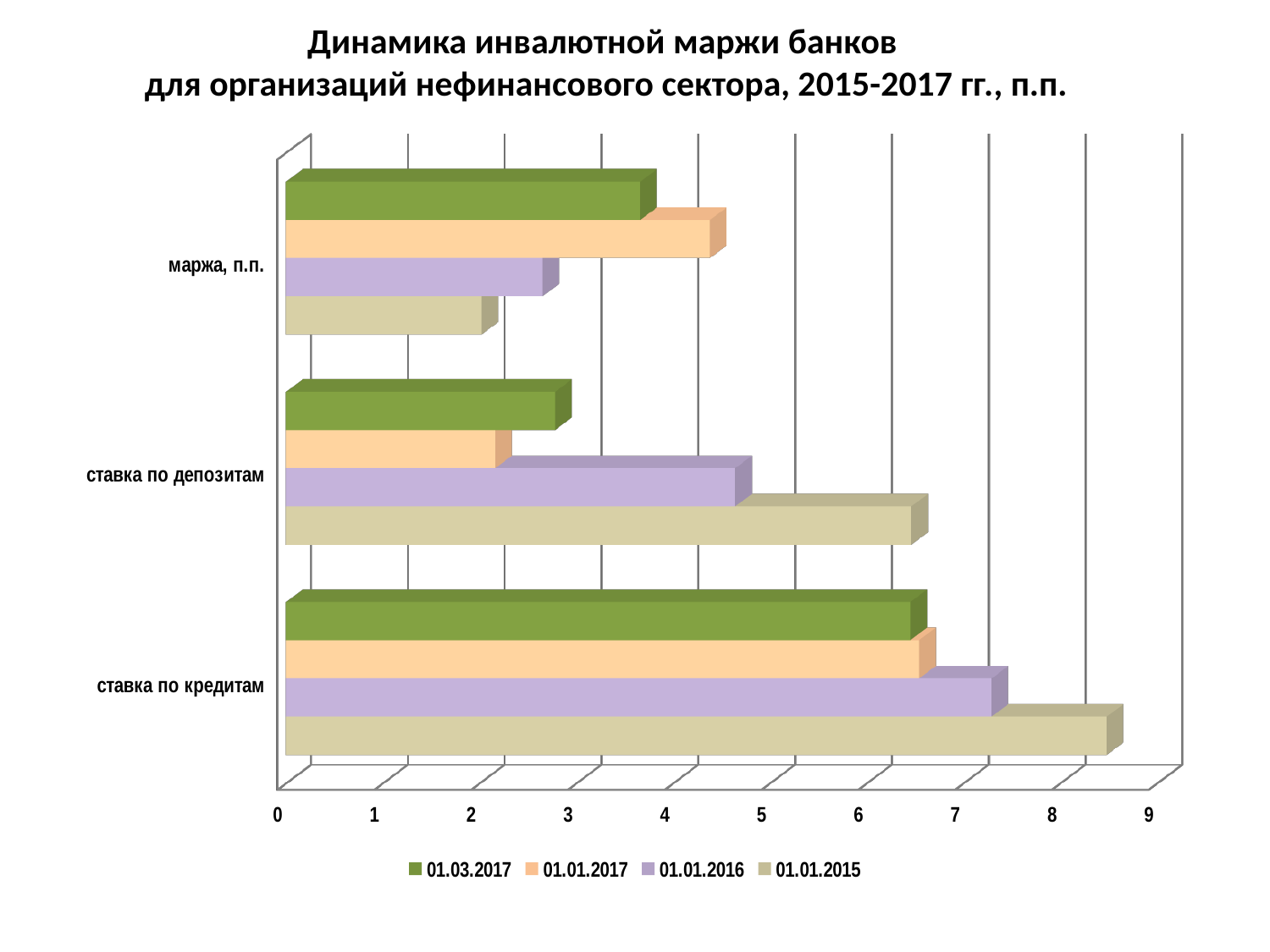
Is the value for ставка по депозитам on 01.01.2016 greater or less than 5? less What kind of chart is shown on the slide? bar chart How many series does the legend list? 4 Is the value for ставка по депозитам on 01.01.2015 greater or less than 6? greater Which series has the highest value for ставка по кредитам? 01.01.2015 For маржа, п.п., which is larger: the value for 01.03.2017 or the value for 01.01.2016? 01.03.2017 Is the value for маржа, п.п. on 01.01.2017 greater or less than 4? greater Which series is shown in green in the legend? 01.03.2017 How many categories are shown on the vertical axis? 3 Which series has the lowest value for ставка по депозитам? 01.01.2017 Which series has the highest value for маржа, п.п.? 01.01.2017